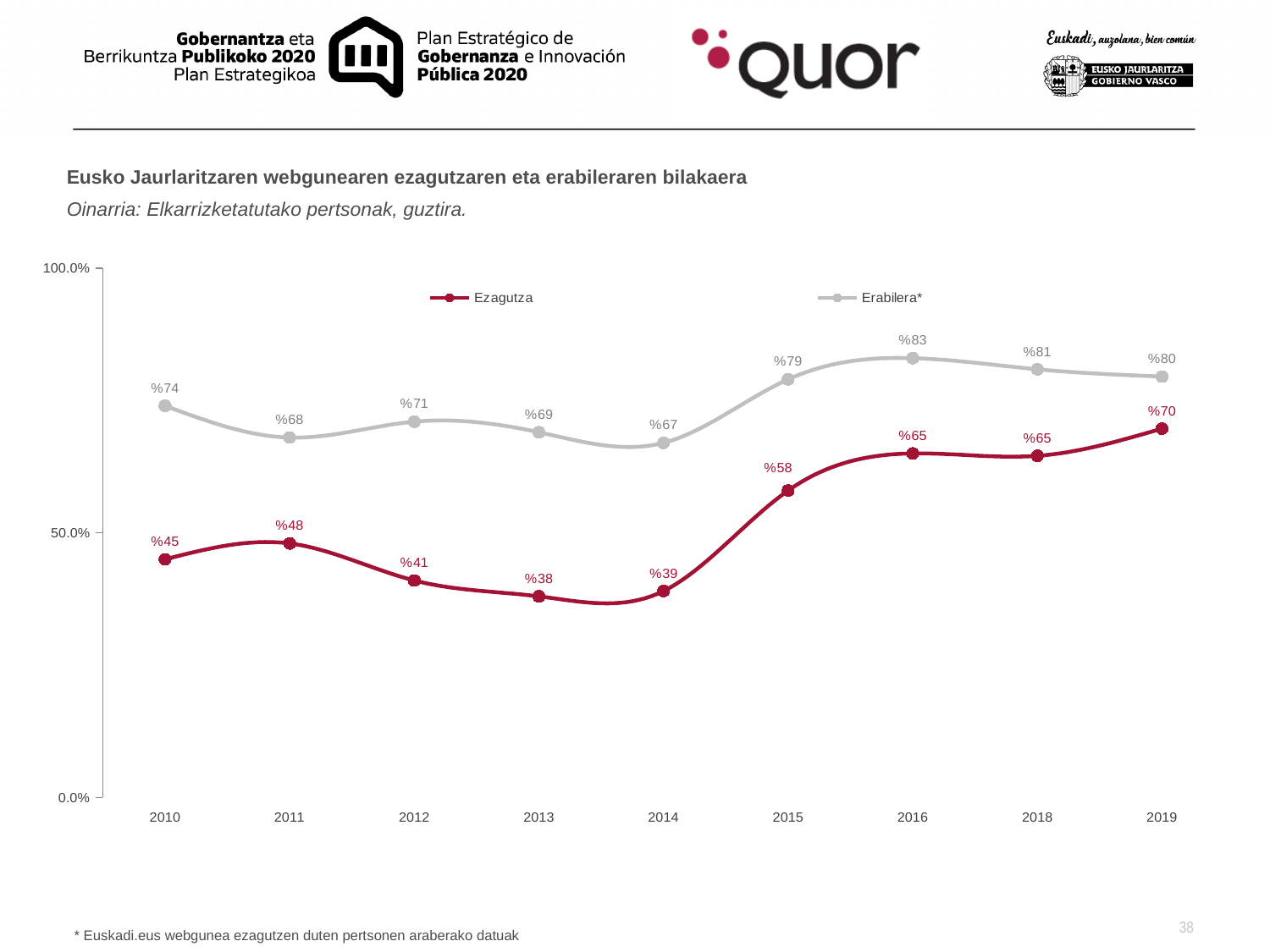
What is the Ezagutza value for 2016? %65 In which year is the Ezagutza series lowest? 2013 What is the Erabilera* value for 2014? %67 How many years are shown on the x axis? 9 In which year is the Erabilera* series highest? 2016 What kind of chart is shown on the slide? line chart Which is larger in 2015: the Ezagutza value or the Erabilera* value? Erabilera* What is the Ezagutza value for 2010? %45 Does the Ezagutza series rise or fall from 2014 to 2016? rise How many series does the legend list? 2 Is the Ezagutza value for 2011 greater or less than 50.0%? less What is the difference between the Erabilera* and Ezagutza values in 2019? %10